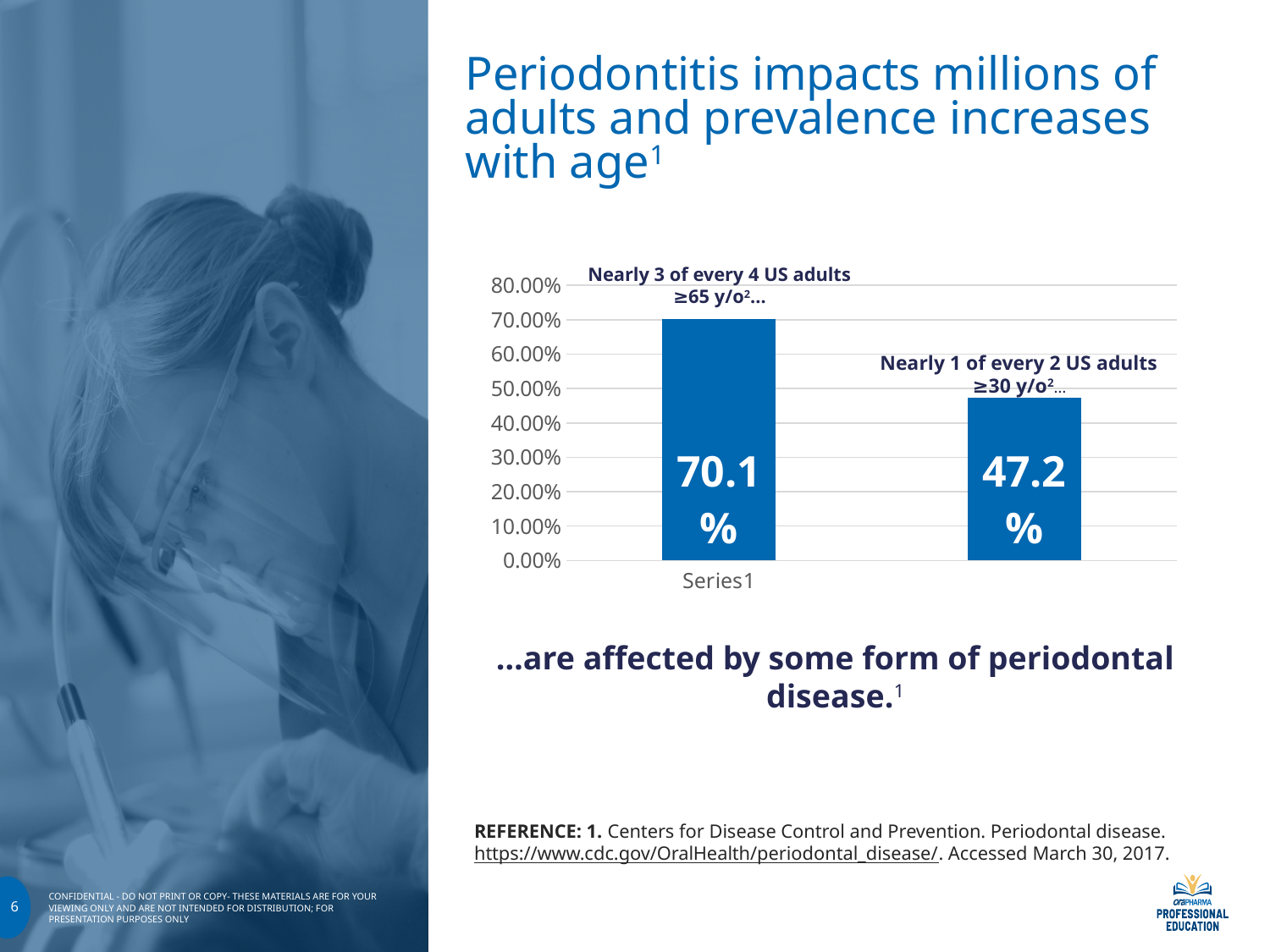
Is the value for adults ≥65 y/o greater or less than 60.00%? greater Is the value for adults ≥65 y/o larger or smaller than the value for adults ≥30 y/o? larger What is the difference between the value for adults ≥65 y/o and the value for adults ≥30 y/o? 22.9% What label appears below the bars on the horizontal axis? Series1 Which age group has the lower bar? US adults ≥30 y/o What kind of chart is shown on the slide? bar chart What is the value shown for US adults ≥65 y/o? 70.1% Which age group has the higher bar? US adults ≥65 y/o How many bars are plotted in the chart? 2 What is the value shown for US adults ≥30 y/o? 47.2% Is the value for adults ≥30 y/o greater or less than 50.00%? less What is the highest value shown on the chart's vertical axis? 80.00%